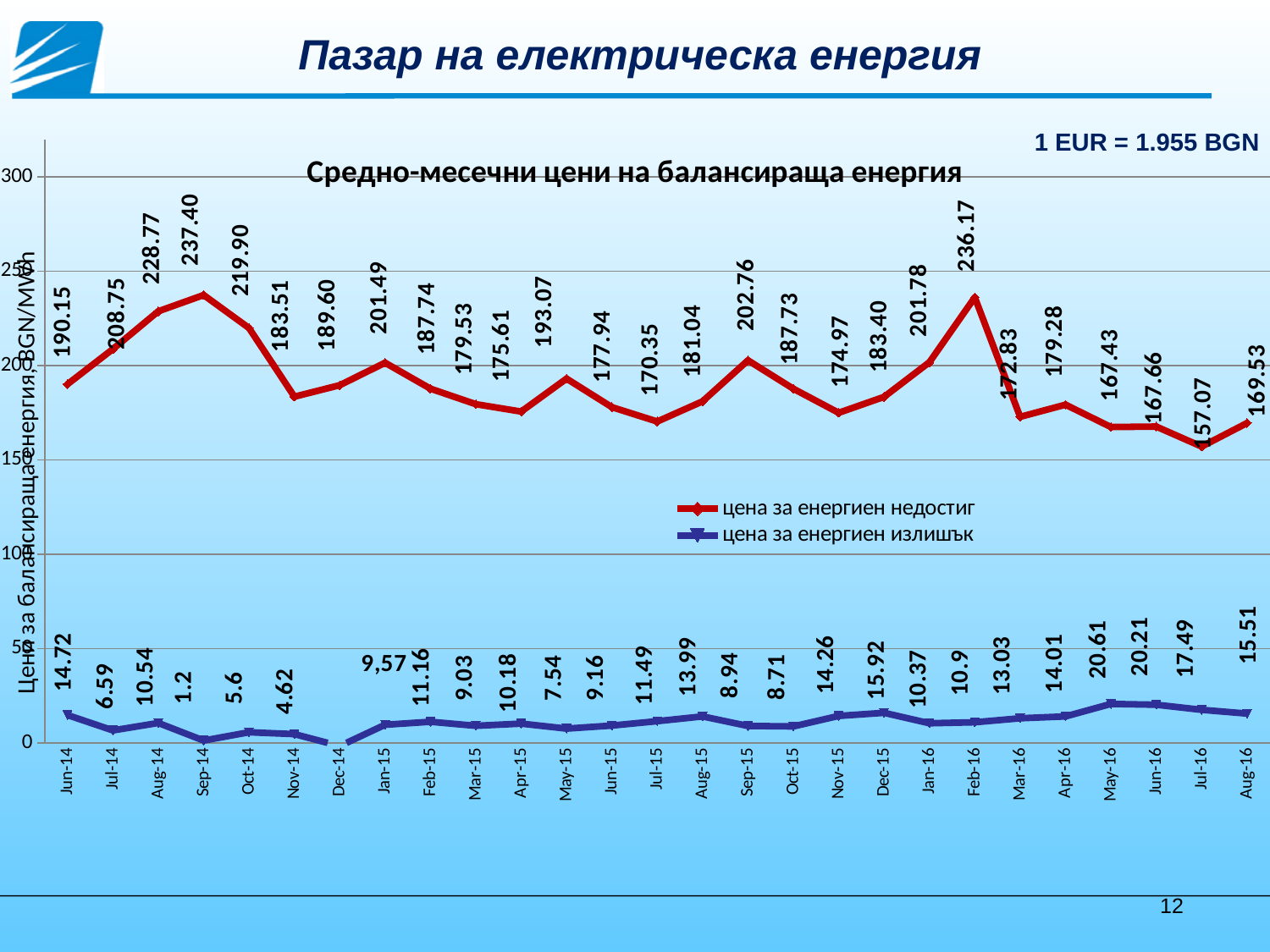
What is the value of 'цена за енергиен излишък' for May-16? 20.61 In which month does 'цена за енергиен излишък' reach its highest value? May-16 What is the value of 'цена за енергиен недостиг' for Sep-14? 237.40 How many months are plotted on the x axis? 27 In which month does 'цена за енергиен недостиг' reach its highest value? Sep-14 What type of chart is shown on the slide? line chart What is the difference between the highest and lowest values of 'цена за енергиен недостиг' (Sep-14 and Jul-16)? 80.33 How many series does the legend list? 2 What is the value of 'цена за енергиен недостиг' for Feb-16? 236.17 What is the title of the chart? Средно-месечни цени на балансираща енергия In which month does 'цена за енергиен недостиг' reach its lowest value? Jul-16 Which is larger for 'цена за енергиен недостиг': Aug-14 or Oct-14? Aug-14